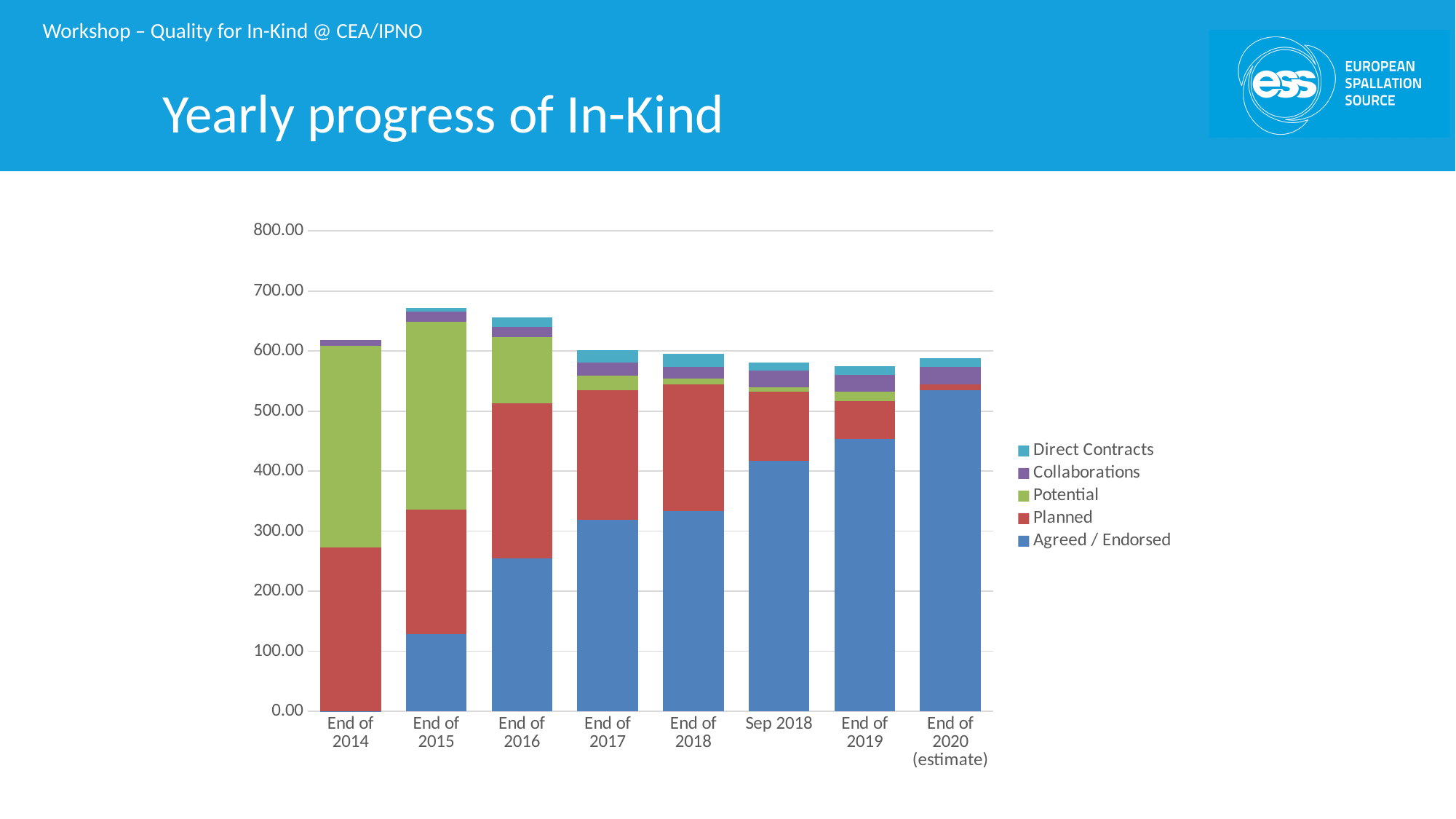
How many series does the chart legend list? 5 Which colour represents the Potential series in the chart? Green Which series is shown at the bottom of each stacked bar? Agreed / Endorsed How many time periods are shown along the x axis of the chart? 8 Does the Agreed / Endorsed series rise or fall from End of 2014 to End of 2020 (estimate)? Rises Is the Agreed / Endorsed value for End of 2015 greater or less than 200? less Does the Potential series rise or fall from End of 2014 to End of 2020 (estimate)? Falls What kind of chart is shown on the slide? Stacked bar chart Which period has the largest Agreed / Endorsed segment? End of 2020 (estimate) Is the total height of the End of 2019 bar greater or less than 600? less Is the total height of the End of 2015 bar greater or less than 600? greater